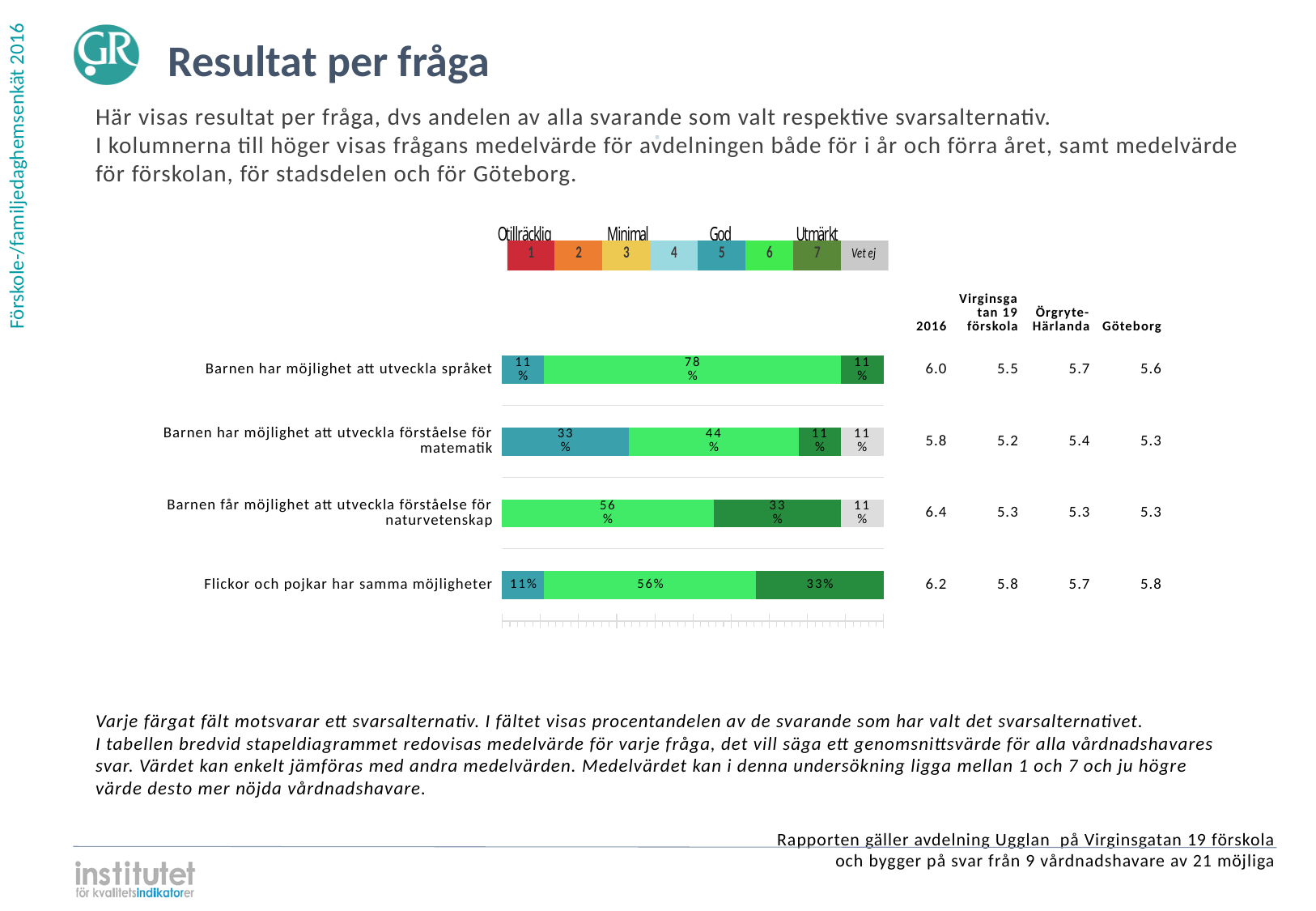
What percentage of respondents chose option 7 for 'Barnen får möjlighet att utveckla förståelse för naturvetenskap'? 33% What percentage of respondents chose option 6 for 'Barnen har möjlighet att utveckla språket'? 78% What type of chart is shown on the slide? Stacked bar chart What is the difference between the option 6 share for 'Barnen har möjlighet att utveckla språket' and for 'Flickor och pojkar har samma möjligheter'? 22 percentage points How many answer options does the legend above the chart list? 8 Which question has the largest share of respondents choosing option 6? Barnen har möjlighet att utveckla språket What percentage of respondents answered 'Vet ej' for 'Barnen har möjlighet att utveckla förståelse för matematik'? 11% How many questions (categories) are plotted in the bar chart? 4 What is the 2016 mean value shown for 'Barnen får möjlighet att utveckla förståelse för naturvetenskap'? 6.4 What is the Göteborg mean value shown for 'Flickor och pojkar har samma möjligheter'? 5.8 Which is larger: the option 7 share for 'Flickor och pojkar har samma möjligheter' or for 'Barnen har möjlighet att utveckla språket'? Flickor och pojkar har samma möjligheter What percentage of respondents chose option 5 for 'Barnen har möjlighet att utveckla förståelse för matematik'? 33%